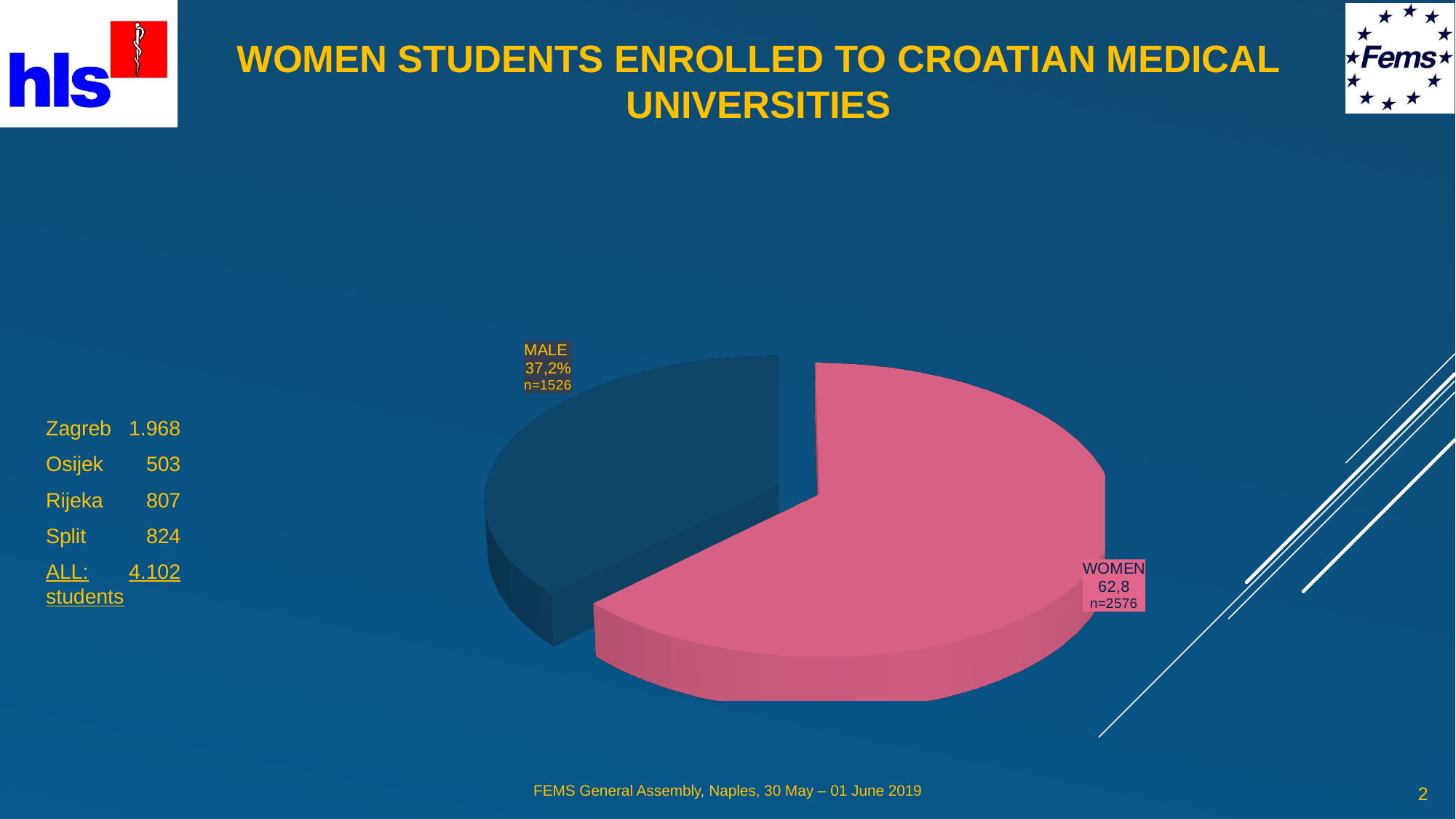
What colour is the WOMEN slice of the pie chart? pink Which slice of the pie chart is the smallest? MALE Which slice of the pie chart is the largest? WOMEN Which slice has the larger n value, MALE or WOMEN? WOMEN What share of the pie is labelled for WOMEN? 62,8 What percentage of the pie is labelled for MALE? 37,2% What is the total of the n values of the two slices? 4102 How many slices does the pie chart have? 2 What is the n value shown for the MALE slice? n=1526 What kind of chart is shown on the slide? pie chart What is the n value shown for the WOMEN slice? n=2576 What is the difference between the n values of the WOMEN and MALE slices? 1050